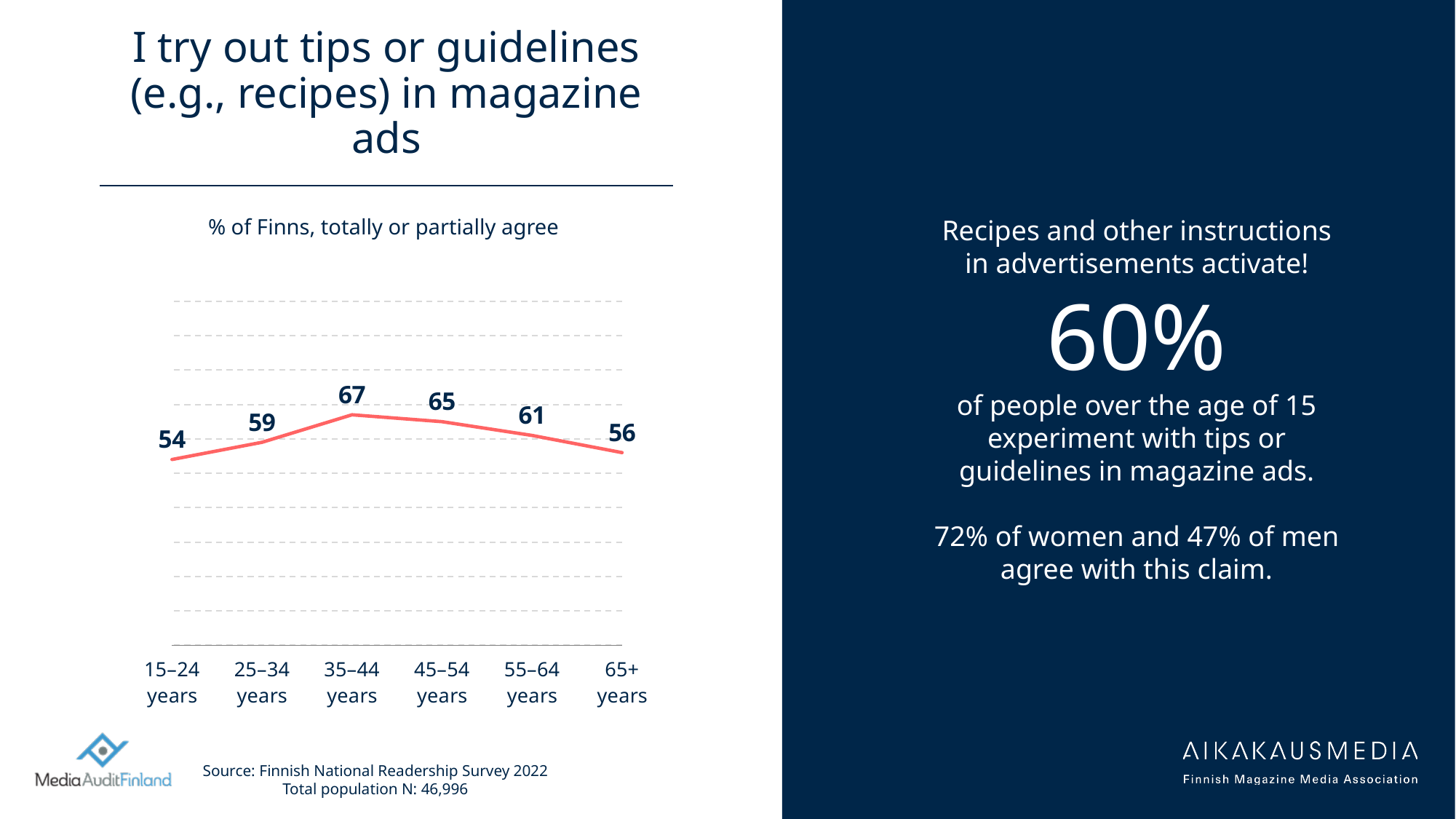
What is the difference between the values for 35–44 years and 15–24 years? 13 How many age groups are plotted on the chart? 6 What kind of chart is shown on the slide? Line chart What is the value for 15–24 years? 54 What is the subtitle shown above the chart? % of Finns, totally or partially agree Which age group has the lowest value? 15–24 years What is the difference between the values for 45–54 years and 55–64 years? 4 What is the value for 35–44 years? 67 Which is larger, the value for 25–34 years or the value for 65+ years? 25–34 years Do the values rise or fall from 35–44 years to 65+ years? Fall What is the value for 65+ years? 56 Which age group has the highest value? 35–44 years